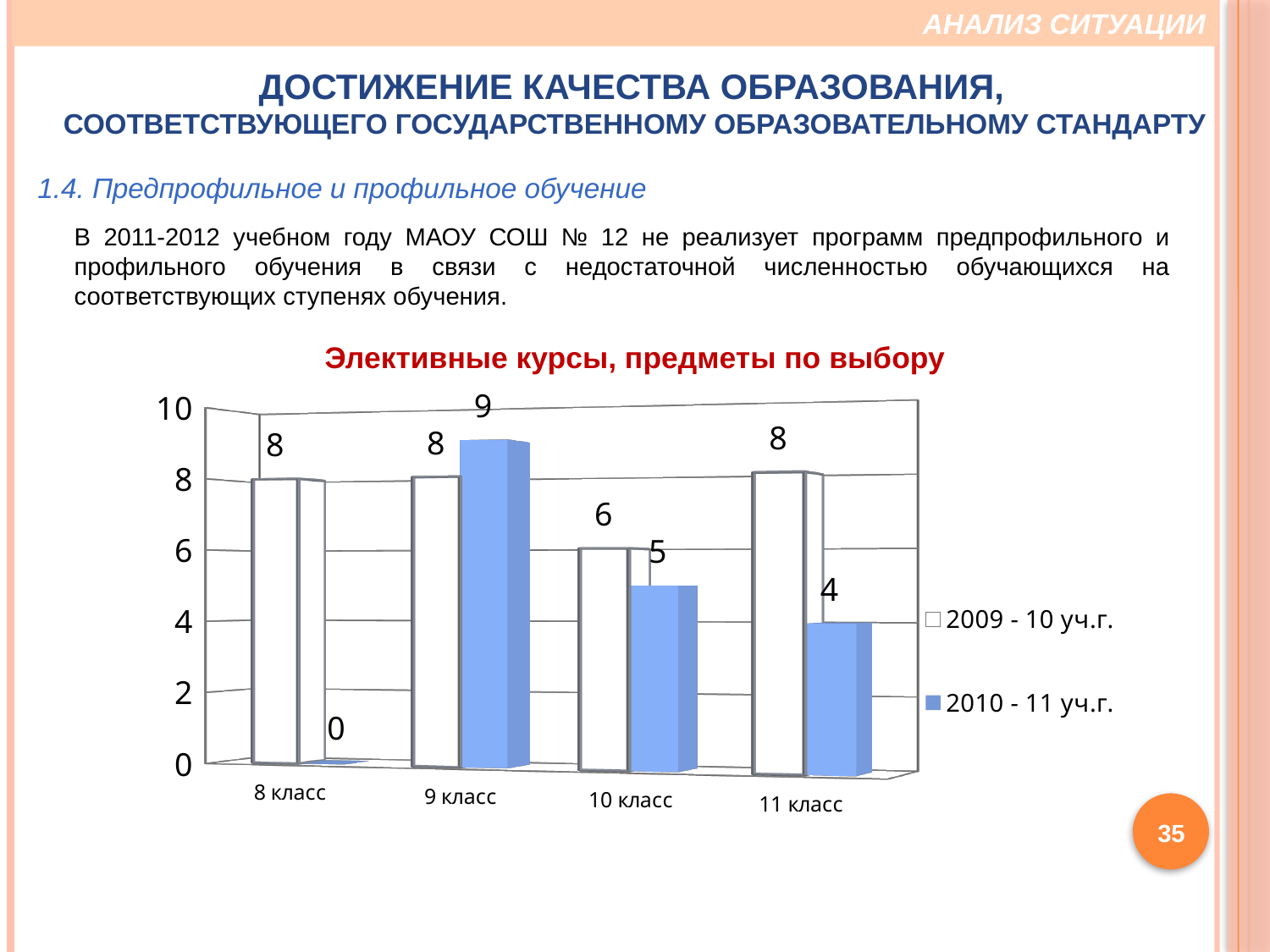
What is the value for 11 класс in the 2010 - 11 уч.г. series? 4 How many series does the legend list? 2 For 9 класс, which series has the larger value: 2009 - 10 уч.г. or 2010 - 11 уч.г.? 2010 - 11 уч.г. Which class has the lowest value in the 2009 - 10 уч.г. series? 10 класс What kind of chart is shown on the slide? Bar chart What is the value for 10 класс in the 2009 - 10 уч.г. series? 6 Which class has the highest value in the 2010 - 11 уч.г. series? 9 класс What is the title of the chart? Элективные курсы, предметы по выбору How many classes (categories) are shown on the x axis? 4 What is the value for 8 класс in the 2010 - 11 уч.г. series? 0 What is the difference between the 2009 - 10 уч.г. and 2010 - 11 уч.г. values for 11 класс? 4 What is the value for 9 класс in the 2010 - 11 уч.г. series? 9